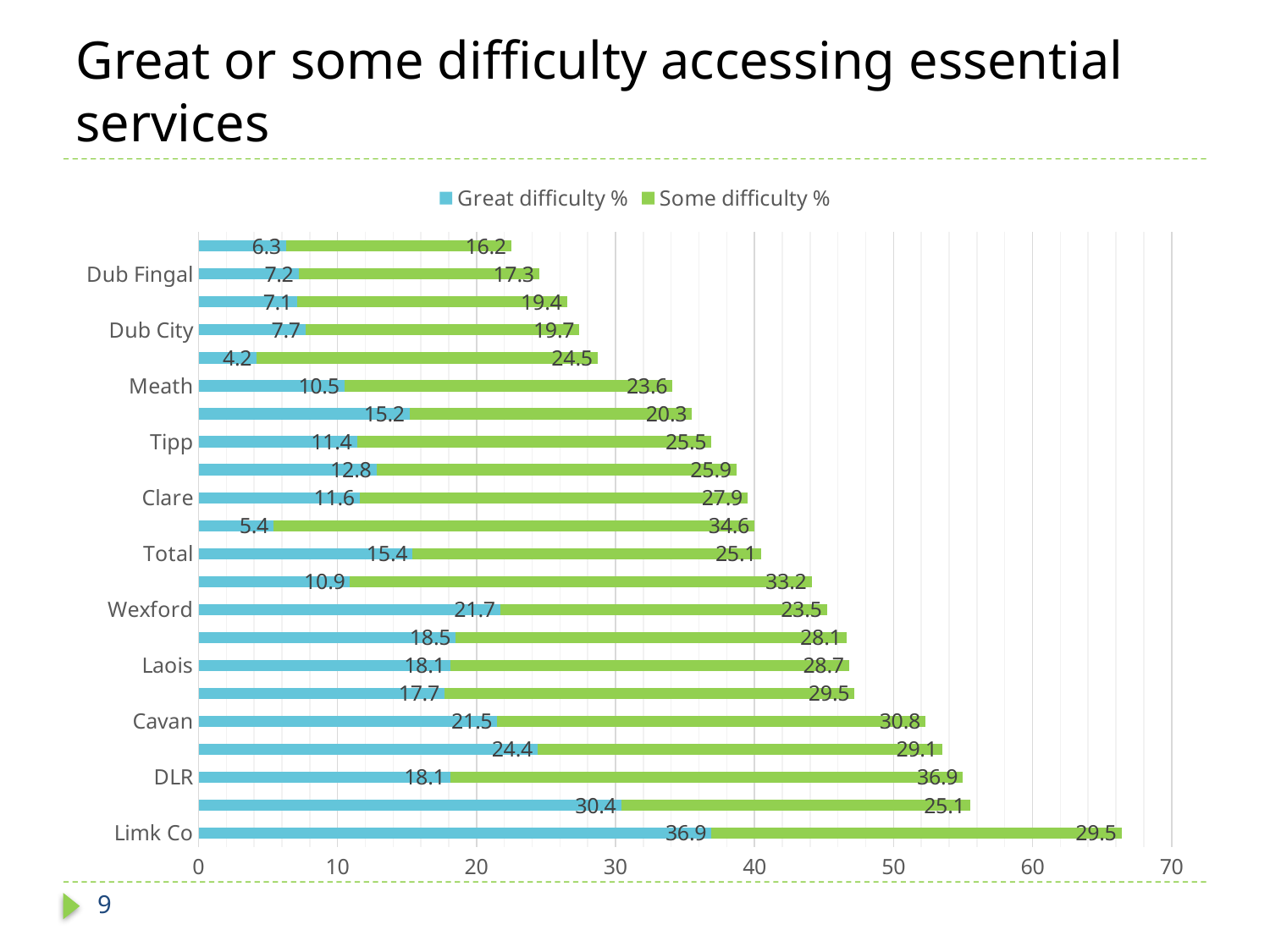
What is the Some difficulty % value for DLR? 36.9 What kind of chart is shown on the slide? Stacked bar chart Which has the larger Great difficulty % value, Wexford or Laois? Wexford What is the title of the slide? Great or some difficulty accessing essential services What is the difference between the Great difficulty % values for Limk Co and Dub Fingal? 29.7 What is the total of the stacked bar for DLR? 55.0 What is the total of the stacked bar for Limk Co? 66.4 What is the Some difficulty % value for Cavan? 30.8 How many series does the legend list? 2 What is the Great difficulty % value for Meath? 10.5 What is the Great difficulty % value for Limk Co? 36.9 Which labelled category has the highest Great difficulty % value? Limk Co